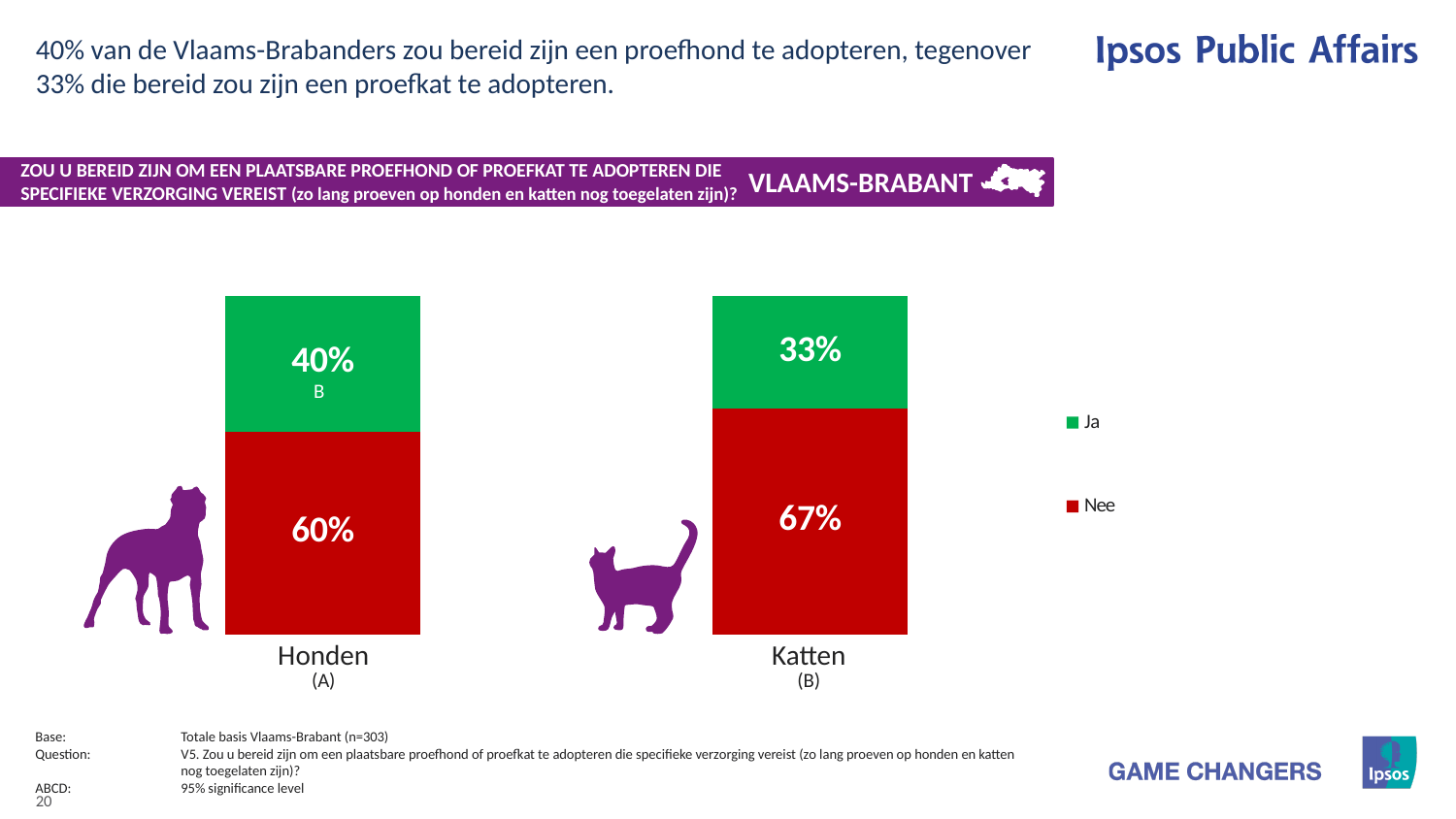
How many categories are shown on the x axis? 2 What percentage of respondents answered 'Ja' for Honden? 40% What is the difference between the 'Nee' and 'Ja' values for Katten? 34% Which category has the highest 'Nee' value? Katten What kind of chart is shown on the slide? Stacked bar chart What percentage of respondents answered 'Ja' for Katten? 33% Which category has the higher 'Ja' share, Honden or Katten? Honden How many series does the legend list? 2 What percentage of respondents answered 'Nee' for Honden? 60% What is the difference between the 'Ja' values for Honden and Katten? 7% What is the total of the stacked bar for Honden? 100% What percentage of respondents answered 'Nee' for Katten? 67%